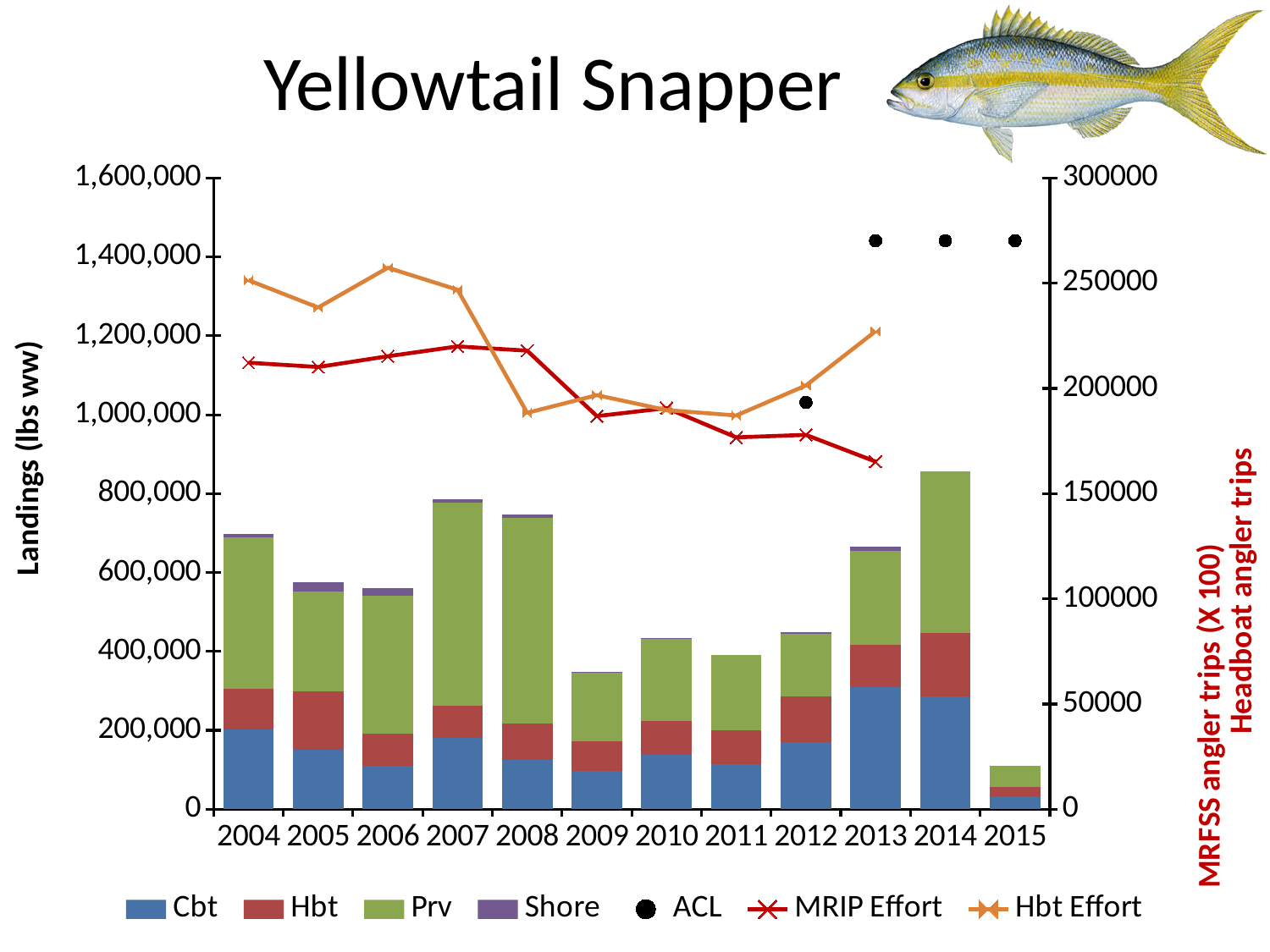
Which year has the larger total landings bar, 2013 or 2010? 2013 Which year has the lowest total landings bar? 2015 Is the total landings bar for 2014 greater or less than 800,000? greater How many series does the legend list? 7 Does the MRIP Effort line rise or fall from 2008 to 2013? fall What is the title of the left vertical axis? Landings (lbs ww) How many years are shown along the x axis? 12 Which year has the highest total landings bar? 2014 Is the total landings bar for 2009 greater or less than 400,000? less What kind of chart is shown on the slide? Stacked bar chart combined with line chart Is the total landings bar for 2015 greater or less than 200,000? less